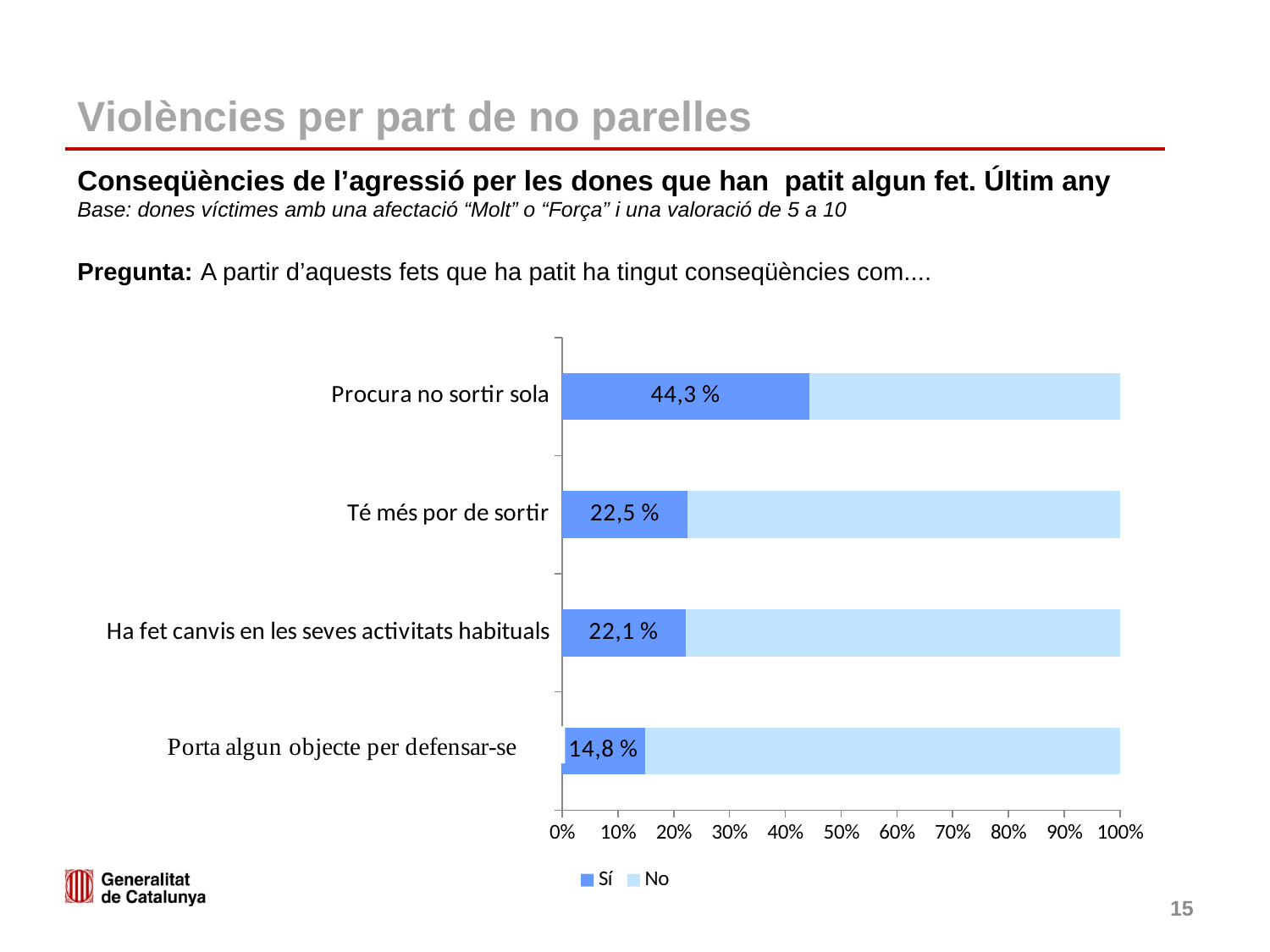
What is the difference between the "Sí" values for "Procura no sortir sola" and "Porta algun objecte per defensar-se"? 29,5 % Which category has the highest "Sí" value? Procura no sortir sola What is the "Sí" value for "Ha fet canvis en les seves activitats habituals"? 22,1 % What is the difference between the "Sí" values for "Té més por de sortir" and "Ha fet canvis en les seves activitats habituals"? 0,4 % How many categories are shown in the chart? 4 What is the "Sí" value for "Procura no sortir sola"? 44,3 % Which has a larger "Sí" value: "Procura no sortir sola" or "Té més por de sortir"? Procura no sortir sola Which category has the lowest "Sí" value? Porta algun objecte per defensar-se How many series does the legend list? 2 What kind of chart is shown on the slide? bar chart What is the "Sí" value for "Porta algun objecte per defensar-se"? 14,8 % What is the "Sí" value for "Té més por de sortir"? 22,5 %